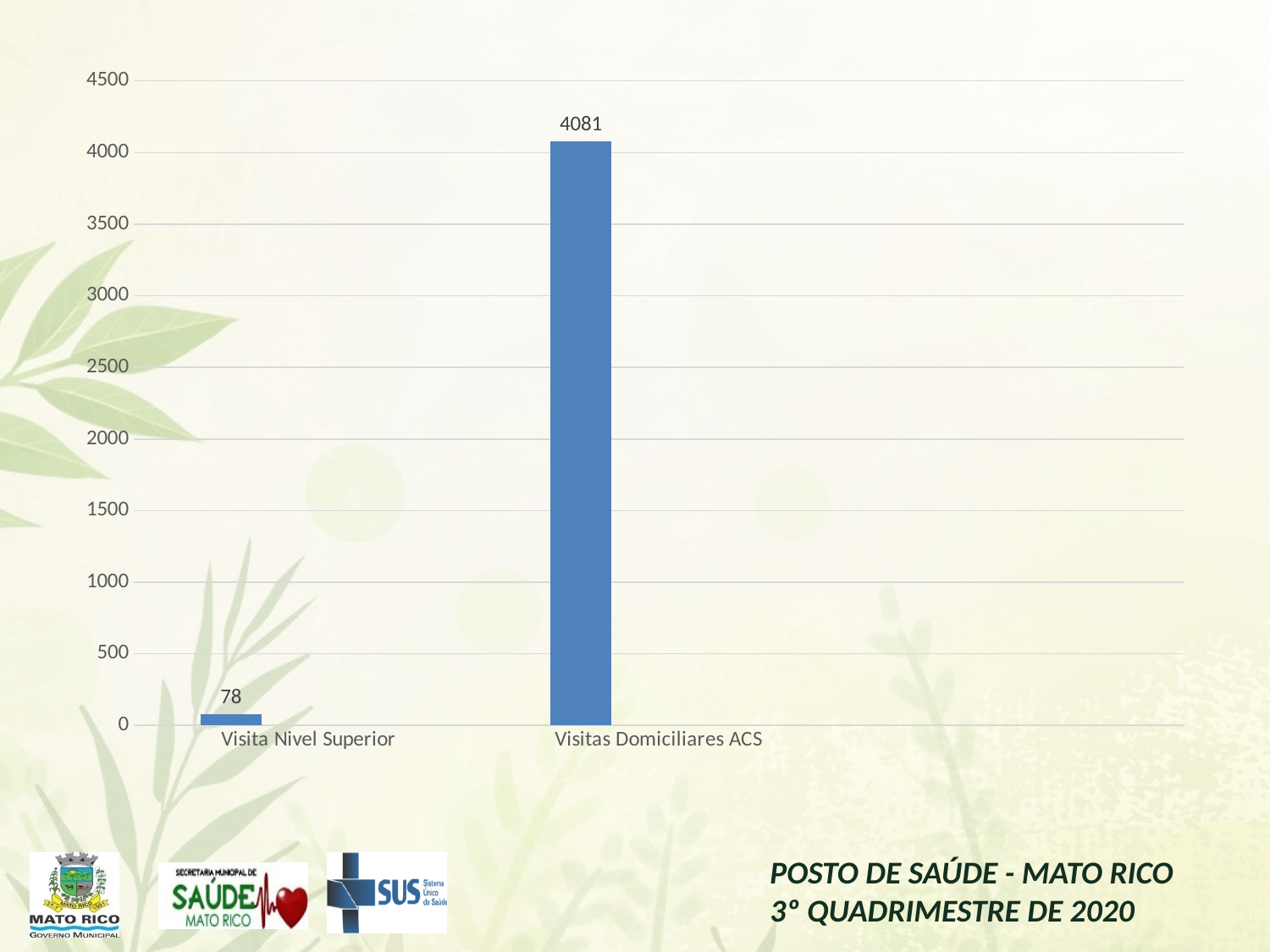
What is the difference between the values for Visitas Domiciliares ACS and Visita Nivel Superior? 4003 Which is larger, the value for Visita Nivel Superior or the value for Visitas Domiciliares ACS? Visitas Domiciliares ACS Is the value for Visita Nivel Superior greater or less than 500? less What is the value for Visita Nivel Superior? 78 What is the value for Visitas Domiciliares ACS? 4081 What kind of chart is shown on the slide? bar chart How many categories are shown on the chart? 2 What is the highest value shown on the vertical axis? 4500 Which category has the lowest value? Visita Nivel Superior What colour are the bars in the chart? blue Is the value for Visitas Domiciliares ACS greater or less than 4000? greater Which category has the highest value? Visitas Domiciliares ACS